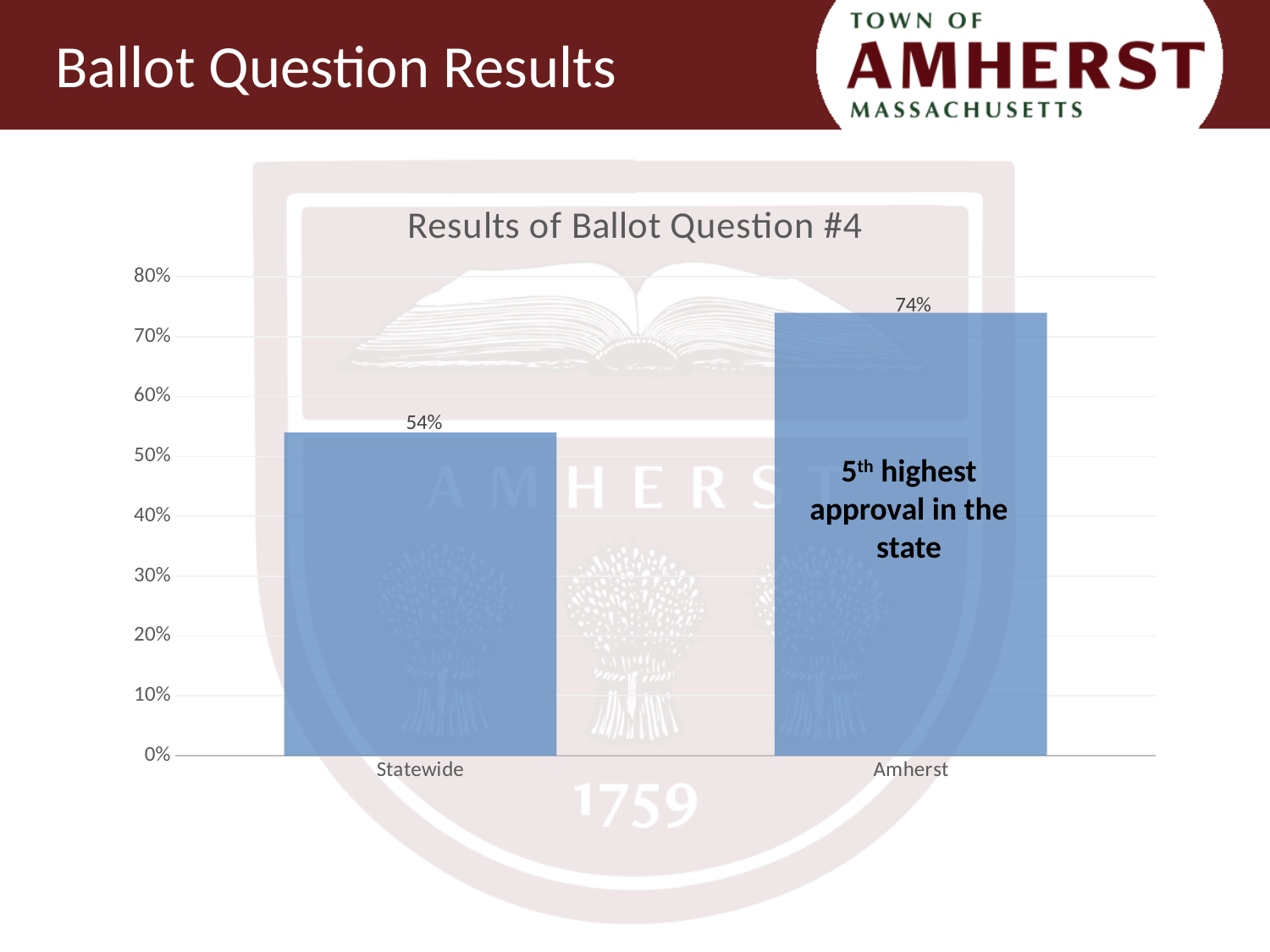
What is the title of the chart? Results of Ballot Question #4 What is the difference between the Amherst and Statewide values? 20% Which is larger, the value for Statewide or the value for Amherst? Amherst What text annotation is placed on the Amherst bar? 5th highest approval in the state Is the value for Amherst greater or less than 70%? greater How many categories are shown on the x axis? 2 Which category has the highest value? Amherst What is the value for Statewide? 54% What is the value for Amherst? 74% Is the value for Statewide greater or less than 60%? less Which category has the lowest value? Statewide What kind of chart is shown? bar chart